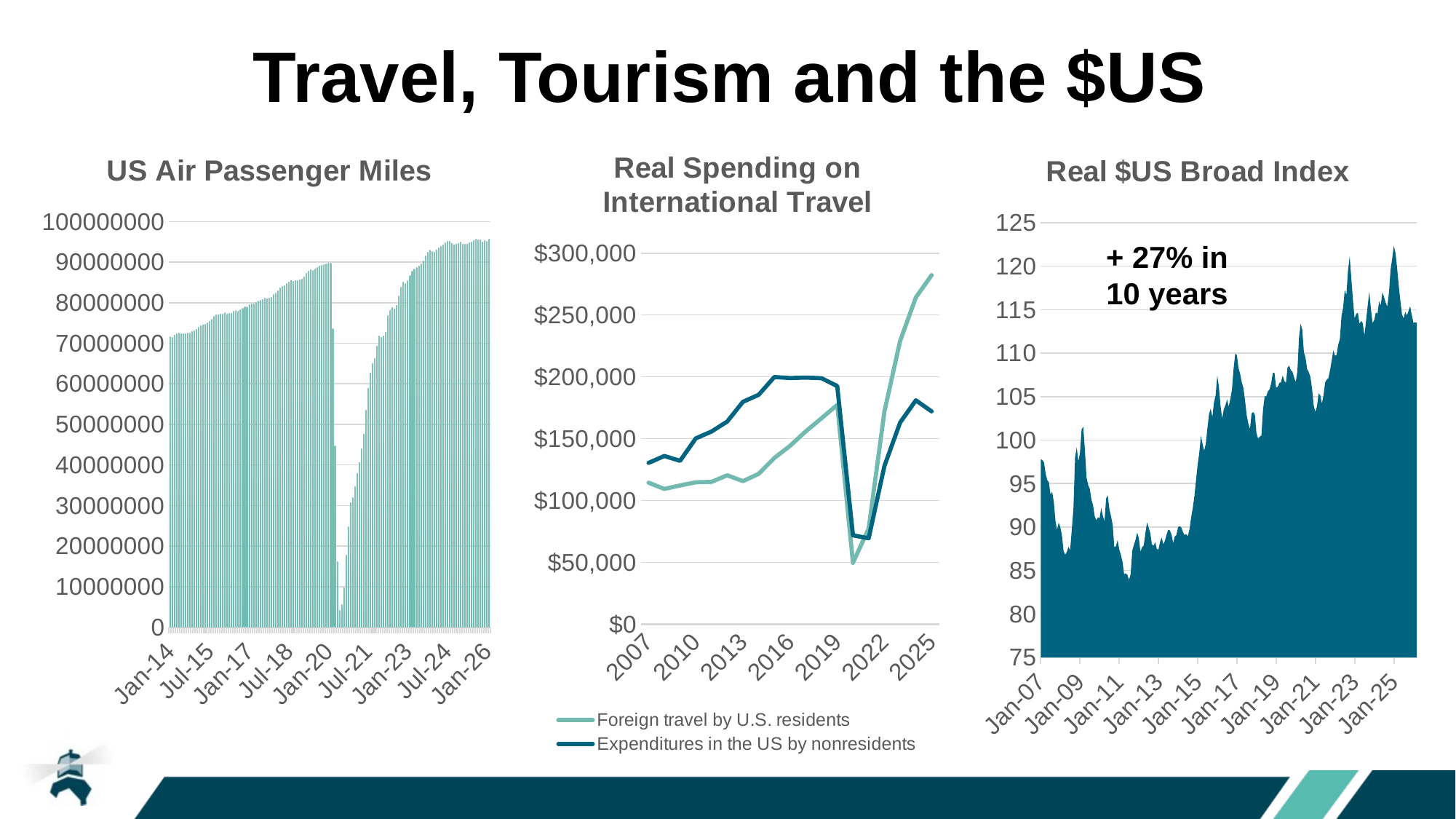
In the Real Spending on International Travel chart, is the value for Expenditures in the US by nonresidents in 2016 greater or less than $150,000? greater How many series does the legend of the Real Spending on International Travel chart list? 2 In the Real Spending on International Travel chart, which series is higher in 2016? Expenditures in the US by nonresidents What kind of chart is the Real Spending on International Travel chart? Line chart What are the two series named in the legend of the Real Spending on International Travel chart? Foreign travel by U.S. residents; Expenditures in the US by nonresidents In the Real $US Broad Index chart, is the value at Jan-11 greater or less than 90? less What annotation is printed on the Real $US Broad Index chart? + 27% in 10 years In the Real Spending on International Travel chart, is the value for Foreign travel by U.S. residents in 2025 greater or less than $250,000? greater In the Real Spending on International Travel chart, which series is higher in 2025? Foreign travel by U.S. residents What kind of chart is the US Air Passenger Miles chart? Bar chart